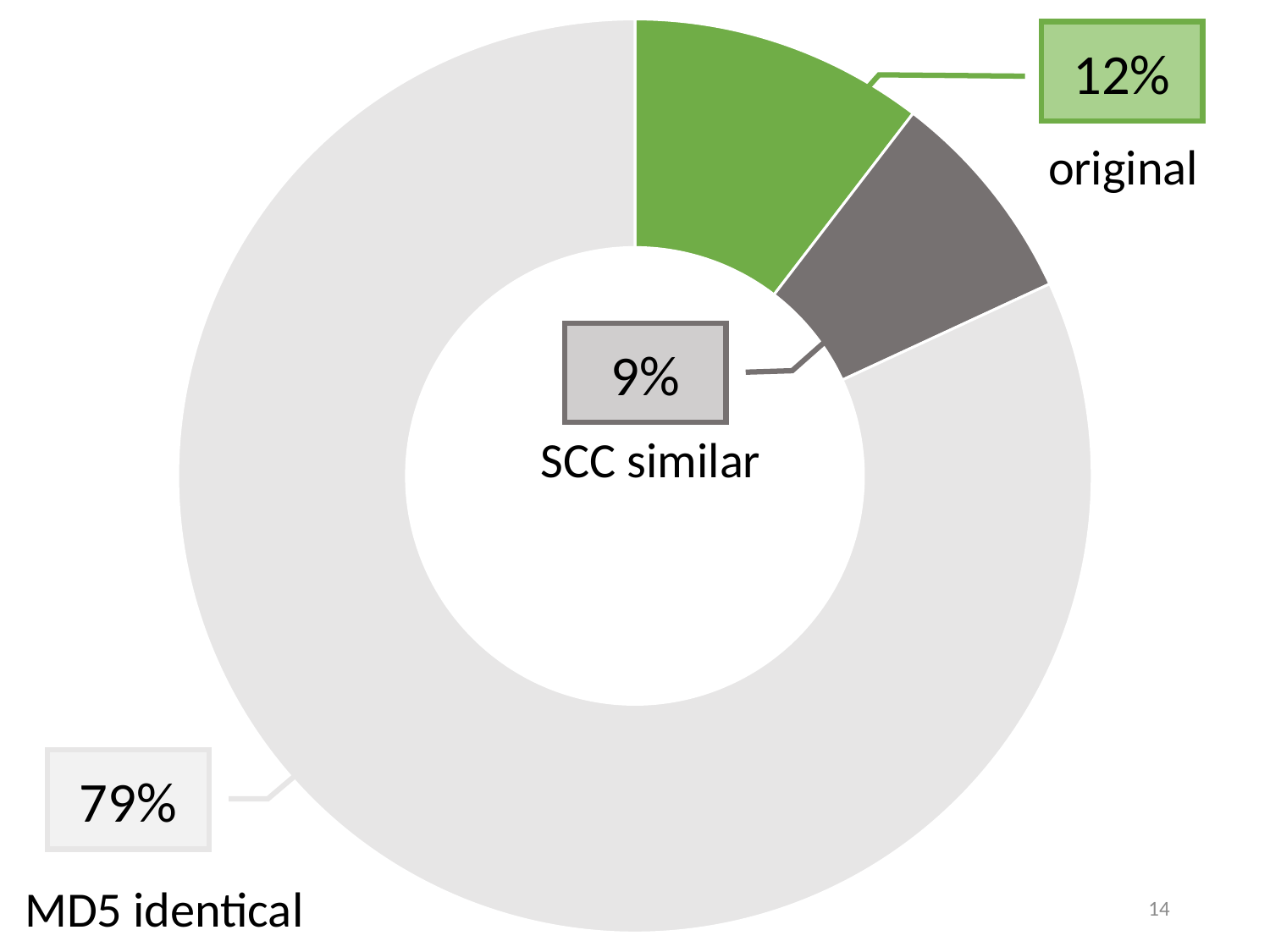
What percentage of the chart is labelled 'SCC similar'? 9% What is the difference in percentage points between 'original' and 'SCC similar'? 3 Which category has the smallest share of the chart? SCC similar What percentage of the chart is labelled 'MD5 identical'? 79% What kind of chart is shown on the slide? Doughnut chart How many categories are shown in the chart? 3 Which category has the largest share of the chart? MD5 identical Which is larger, the share for 'original' or the share for 'SCC similar'? original What percentage of the chart is labelled 'original'? 12% What colour is the 'original' segment of the chart? Green What is the difference in percentage points between 'MD5 identical' and 'original'? 67 What colour is the 'SCC similar' segment of the chart? Dark grey